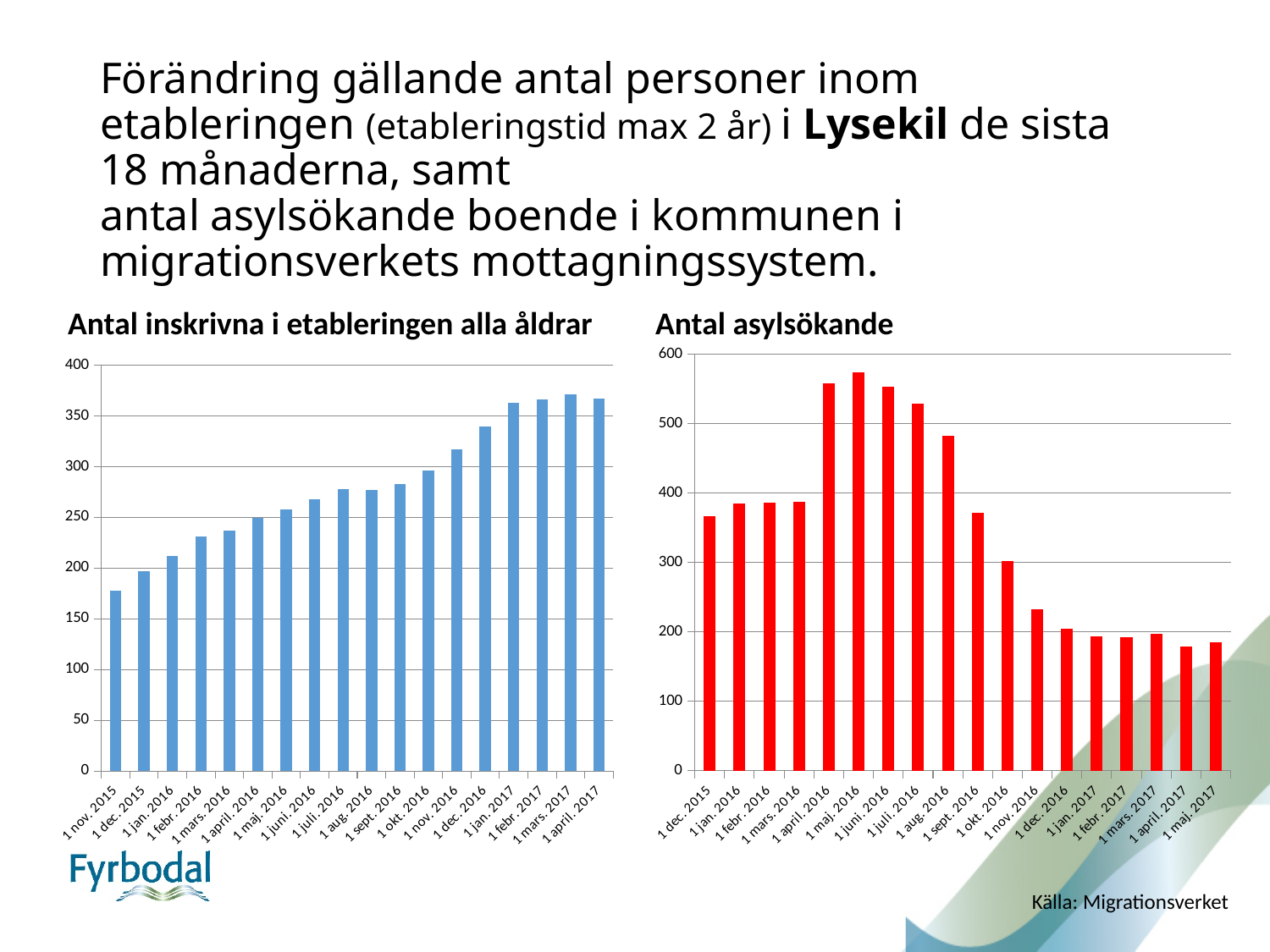
In the right chart 'Antal asylsökande', is the value for 1 nov. 2016 greater or less than 300? less What kind of chart is the left chart titled 'Antal inskrivna i etableringen alla åldrar'? bar chart In the left chart 'Antal inskrivna i etableringen alla åldrar', is the value for 1 april 2017 greater or less than 350? greater What is the title of the right chart on the slide? Antal asylsökande In the left chart 'Antal inskrivna i etableringen alla åldrar', do the values generally rise or fall from left to right along the x axis? rise In the left chart 'Antal inskrivna i etableringen alla åldrar', how many bars (dates) are plotted? 18 In the right chart 'Antal asylsökande', which date has the highest value? 1 maj. 2016 In the left chart 'Antal inskrivna i etableringen alla åldrar', which date has the lowest value? 1 nov. 2015 In the left chart 'Antal inskrivna i etableringen alla åldrar', which is larger, the value for 1 nov. 2016 or the value for 1 dec. 2016? 1 dec. 2016 In the left chart 'Antal inskrivna i etableringen alla åldrar', is the value for 1 nov. 2015 greater or less than 200? less In the right chart 'Antal asylsökande', which is larger, the value for 1 april 2016 or the value for 1 aug. 2016? 1 april 2016